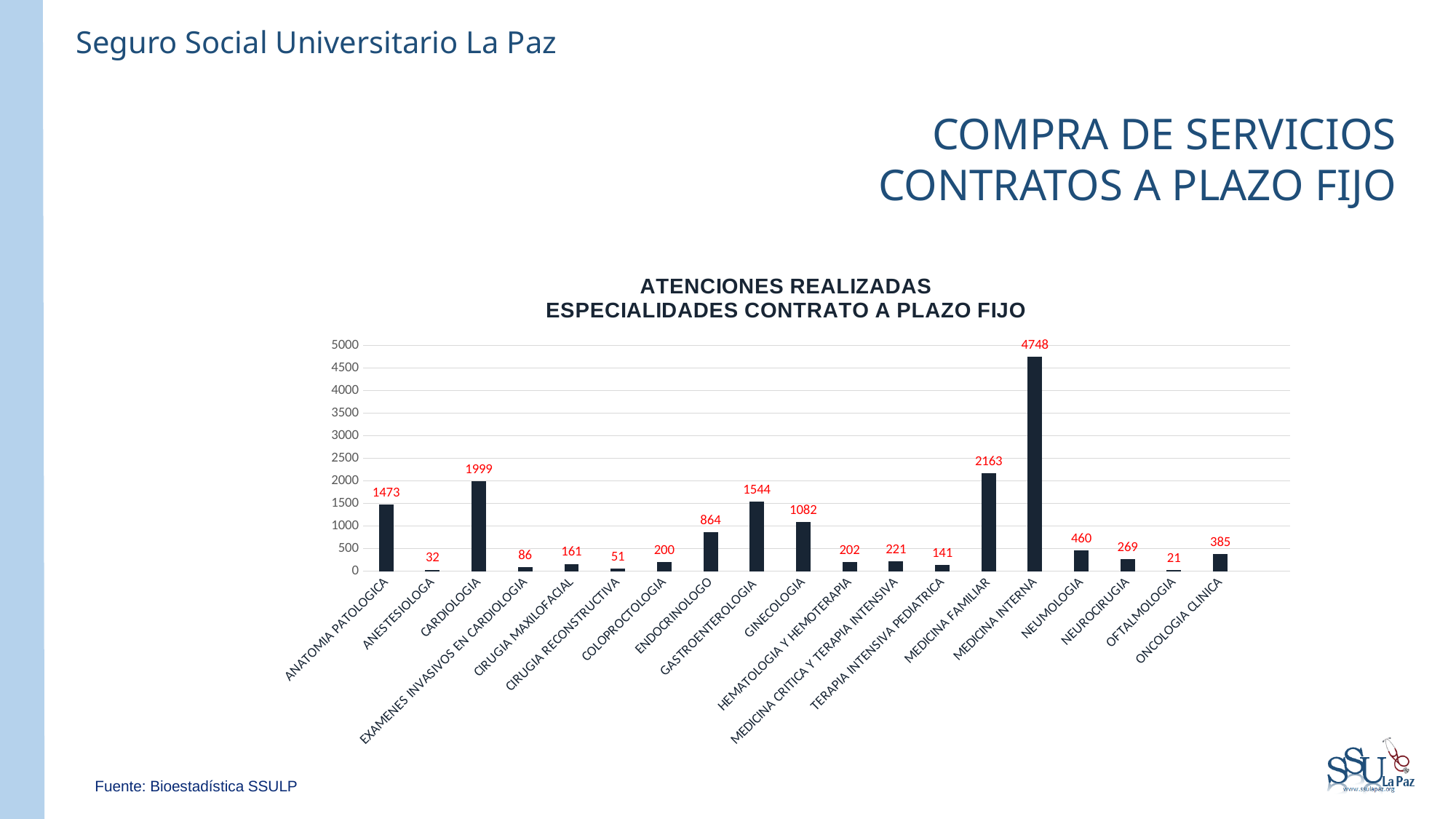
Which specialty has the highest number of atenciones? MEDICINA INTERNA What is the difference between MEDICINA INTERNA and MEDICINA FAMILIAR? 2585 How many specialties are shown on the chart? 19 What kind of chart is this? Bar chart Which is larger, GINECOLOGIA or ENDOCRINOLOGO? GINECOLOGIA Which specialty has the lowest number of atenciones? OFTALMOLOGIA What is the title of the chart? ATENCIONES REALIZADAS ESPECIALIDADES CONTRATO A PLAZO FIJO What is the value for CARDIOLOGIA? 1999 What is the value for GASTROENTEROLOGIA? 1544 What is the value for MEDICINA INTERNA? 4748 What is the value for OFTALMOLOGIA? 21 What is the difference between CARDIOLOGIA and ANATOMIA PATOLOGICA? 526